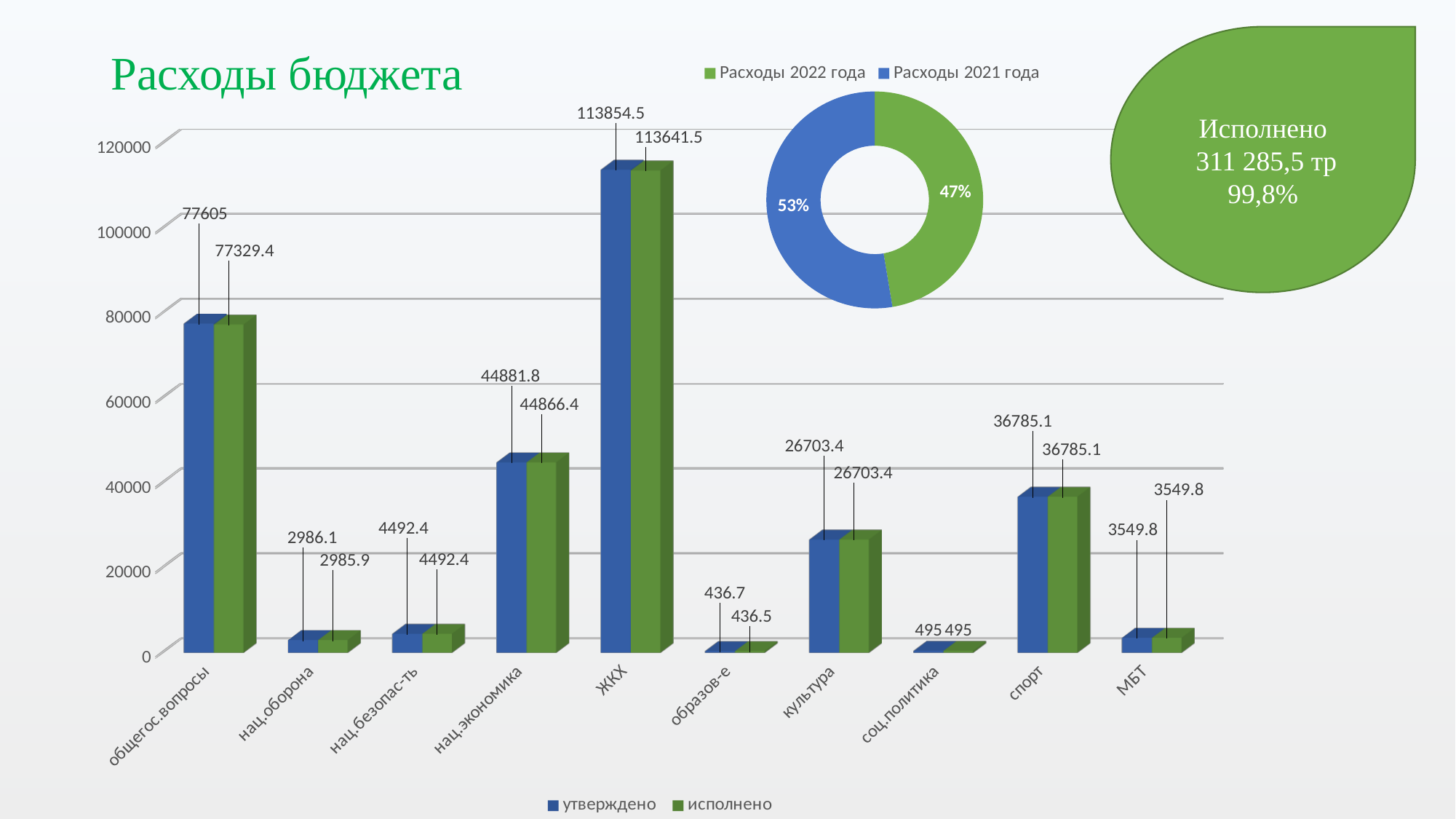
In the doughnut chart, what share is shown for Расходы 2021 года? 53% How many categories are shown on the x axis of the bar chart? 10 How many series does the legend of the bar chart list? 2 In the bar chart, is the утверждено value for общегос.вопросы greater or less than 60000? greater In the bar chart, which category has the lowest исполнено value? образов-е In the bar chart, which is larger: the утверждено value for спорт or the утверждено value for культура? спорт In the bar chart, what is the утверждено value for ЖКХ? 113854.5 In the bar chart, what is the исполнено value for нац.экономика? 44866.4 In the bar chart, what is the difference between the утверждено and исполнено values for ЖКХ? 213 What type of chart is the chart at the top centre of the slide showing 47% and 53%? doughnut chart In the bar chart, what is the исполнено value for общегос.вопросы? 77329.4 In the bar chart, which category has the highest утверждено value? ЖКХ